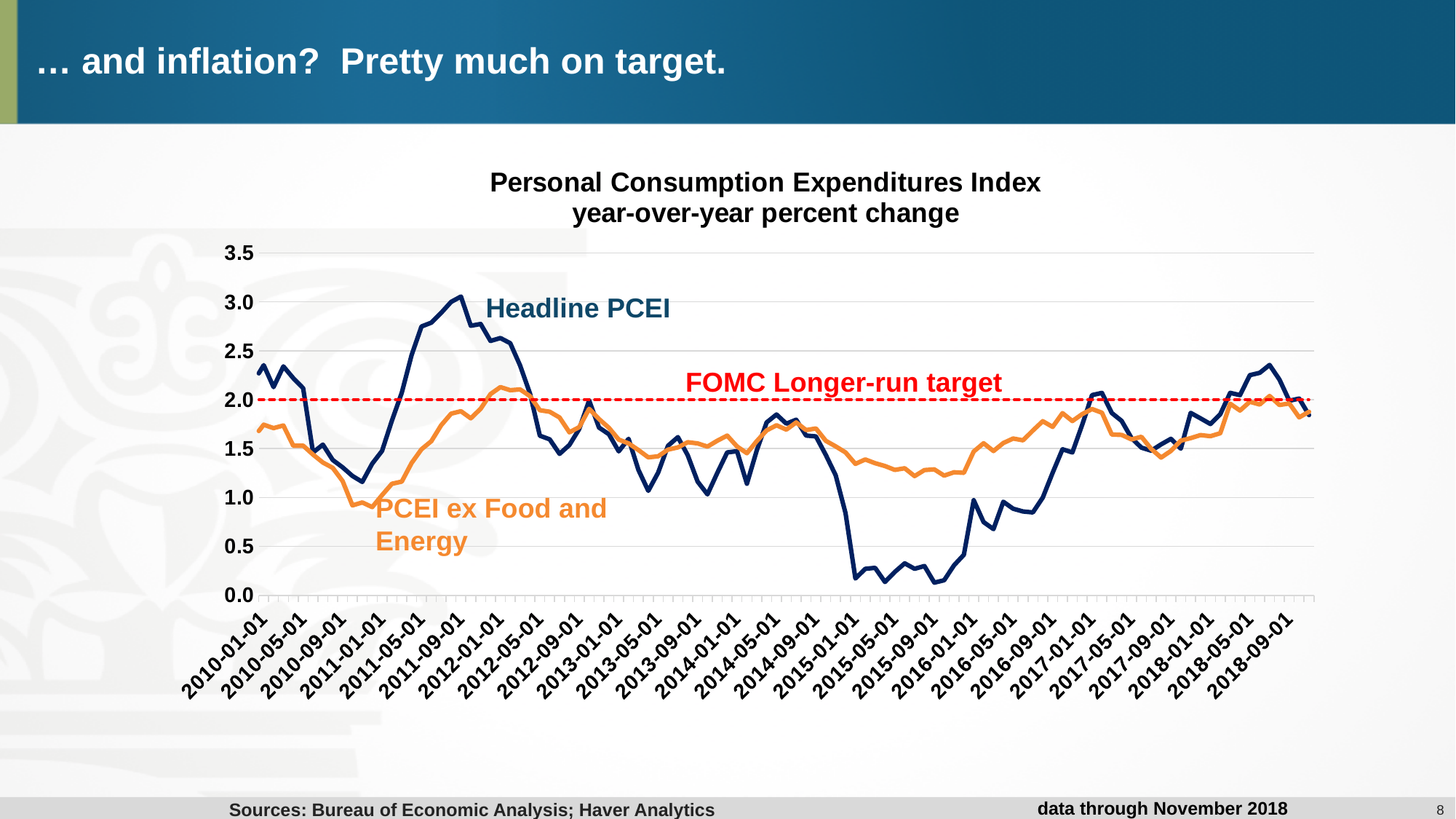
At 2015-05-01, which series is higher: Headline PCEI or PCEI ex Food and Energy? PCEI ex Food and Energy Is the Headline PCEI value at 2015-05-01 greater or less than 0.5? less What is the title of the chart? Personal Consumption Expenditures Index year-over-year percent change What kind of chart is shown on the slide? line chart How many date labels are shown on the x axis? 27 At what level is the FOMC Longer-run target line drawn? 2.0 At 2011-09-01, which series is higher: Headline PCEI or PCEI ex Food and Energy? Headline PCEI Which series reaches the highest value anywhere on the chart? Headline PCEI Is the Headline PCEI value at 2011-09-01 greater or less than 2.5? greater Is the PCEI ex Food and Energy value at 2015-05-01 greater or less than 1.0? greater Which series is drawn in orange? PCEI ex Food and Energy Does the Headline PCEI series rise or fall between 2014-09-01 and 2015-01-01? fall